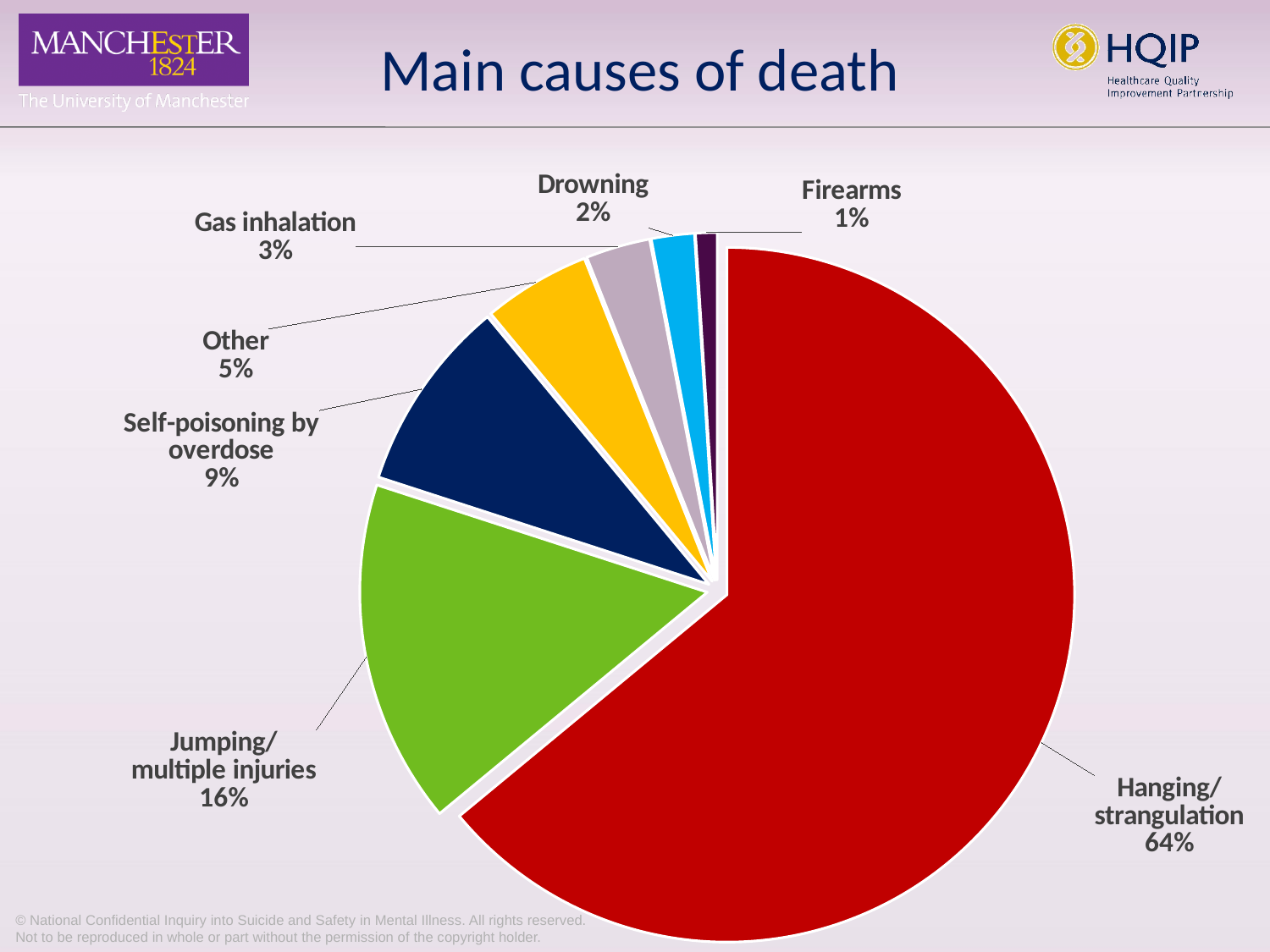
What is the difference in percentage points between Hanging/strangulation and Jumping/multiple injuries? 48 What kind of chart is shown on the slide? pie chart What is the difference in percentage points between Self-poisoning by overdose and Gas inhalation? 6 What share of deaths is attributed to Hanging/strangulation? 64% What percentage is shown for Self-poisoning by overdose? 9% How many slices does the pie chart have? 7 What is the title of the chart? Main causes of death Which is larger, the share for Drowning or the share for Other? Other What percentage is shown for Gas inhalation? 3% Which cause of death has the smallest slice? Firearms What percentage is shown for Jumping/multiple injuries? 16% Which cause of death has the largest slice? Hanging/strangulation